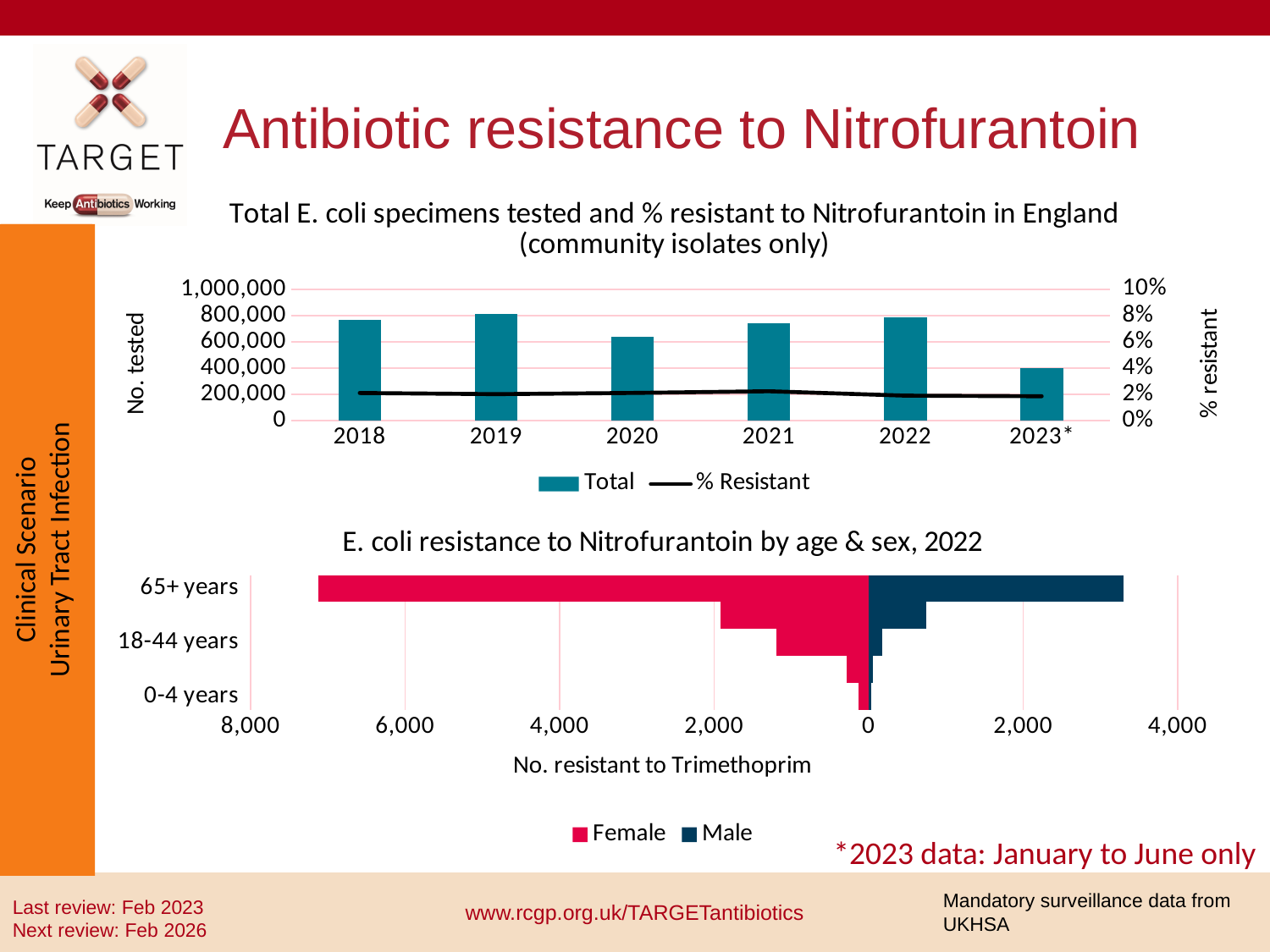
In the top chart, does the number tested rise or fall from 2022 to 2023*? fall In the top chart, which year has the larger number tested, 2020 or 2021? 2021 In the top chart, is the number tested in 2020 greater or less than 800,000? less In the bottom chart, is the Female value for 65+ years greater or less than 6,000? greater In the top chart, which year has the lowest number tested? 2023* In the top chart, how many years are shown on the x axis? 6 In the bottom chart, what is the label on the horizontal axis? No. resistant to Trimethoprim In the top chart, is the number tested in 2023* greater or less than 600,000? less In the bottom chart, 'E. coli resistance to Nitrofurantoin by age & sex, 2022', how many series does the legend list? 2 In the top chart, how many series does the legend list? 2 In the bottom chart, which age group has the highest Female value? 65+ years In the top chart, 'Total E. coli specimens tested and % resistant to Nitrofurantoin in England', what kind of chart is used? A bar chart with a line